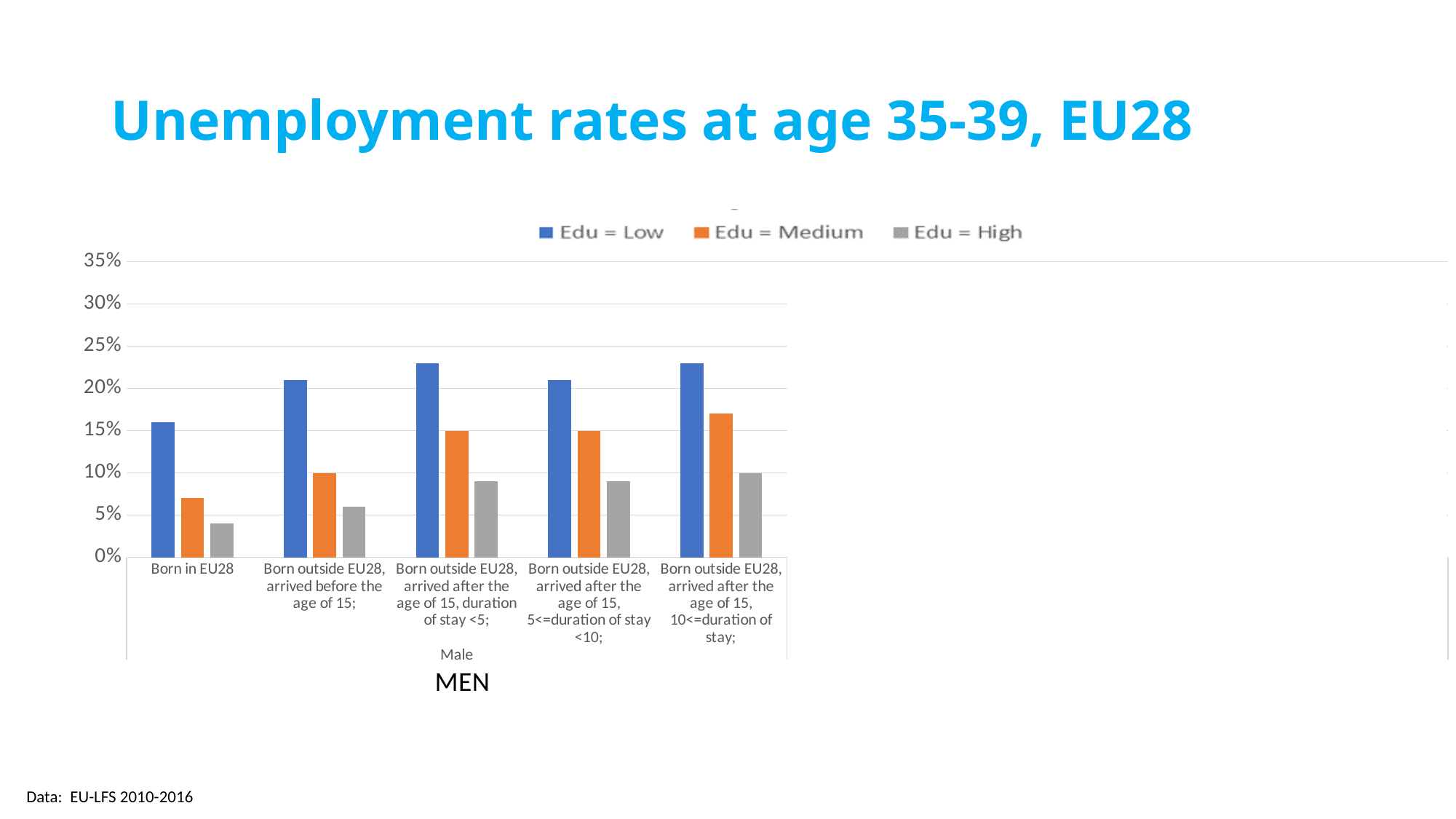
Is the Edu = High value for Born in EU28 greater or less than 5%? less Which category has the highest Edu = Medium unemployment rate? Born outside EU28, arrived after the age of 15, 10<=duration of stay; Is the Edu = Medium value for Born in EU28 greater or less than 10%? less Which series is shown in orange in the legend? Edu = Medium How many series does the legend list? 3 Is the Edu = High value for Born outside EU28, arrived before the age of 15 greater or less than 10%? less Which category has the lowest Edu = Low unemployment rate? Born in EU28 How many categories are shown along the x axis? 5 Which category has the lowest Edu = High unemployment rate? Born in EU28 What kind of chart is shown on the slide? bar chart For Born in EU28, which is larger: the Edu = Low value or the Edu = High value? Edu = Low